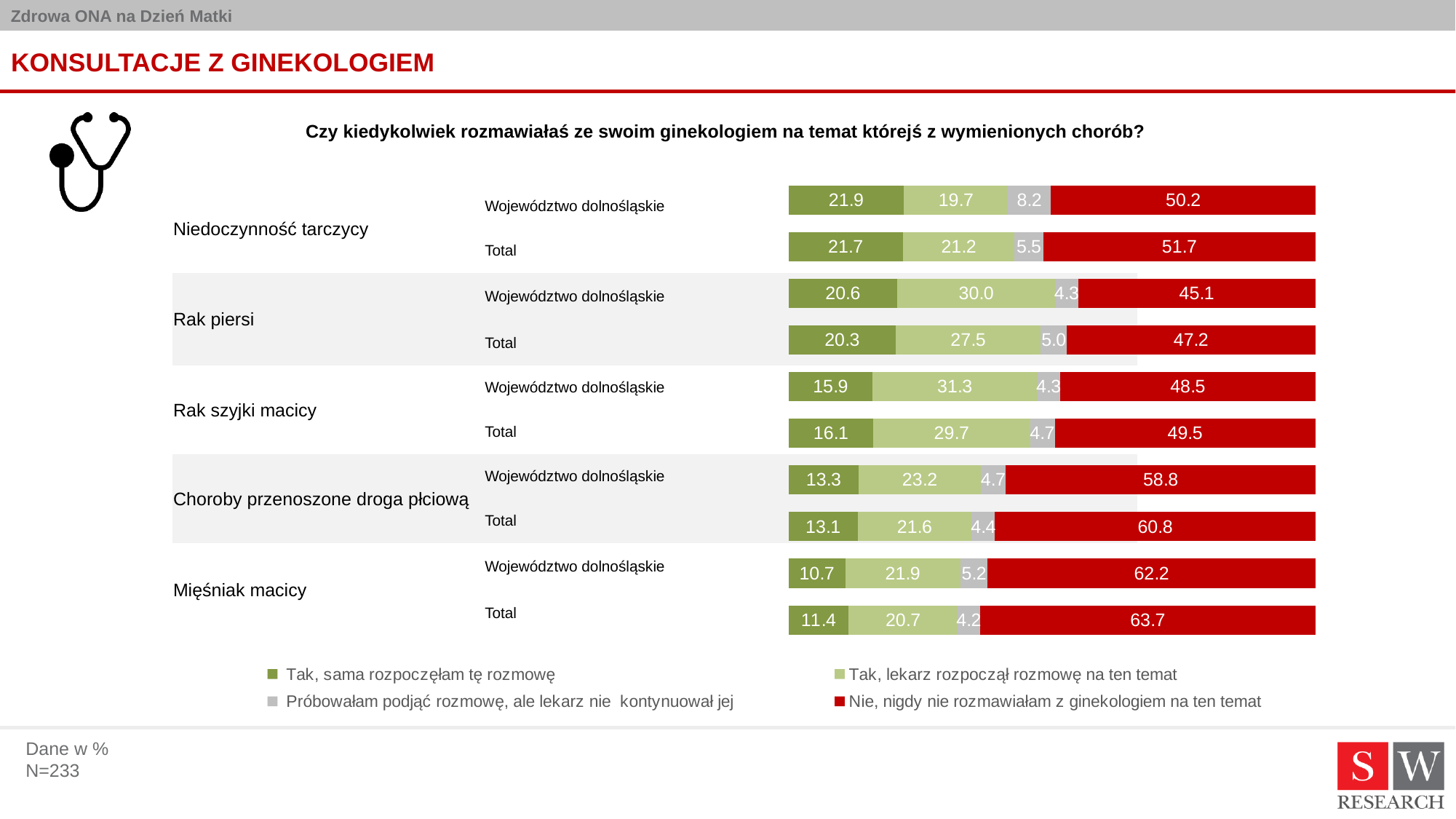
How many bars are shown in the chart? 10 For Choroby przenoszone droga płciową, what is the difference between the Total and Województwo dolnośląskie values for "Nie, nigdy nie rozmawiałam z ginekologiem na ten temat"? 2.0 What is the value for "Nie, nigdy nie rozmawiałam z ginekologiem na ten temat" in the Total bar for Mięśniak macicy? 63.7 For Województwo dolnośląskie, which has the larger value for "Tak, lekarz rozpoczął rozmowę na ten temat": Rak szyjki macicy or Rak piersi? Rak szyjki macicy Which bar has the highest value for "Tak, lekarz rozpoczął rozmowę na ten temat"? Rak szyjki macicy, Województwo dolnośląskie (31.3) How many series does the legend list? 4 What is the total of the Województwo dolnośląskie bar for Niedoczynność tarczycy? 100.0 What is the value for "Próbowałam podjąć rozmowę, ale lekarz nie kontynuował jej" in the Województwo dolnośląskie bar for Niedoczynność tarczycy? 8.2 What kind of chart is shown on the slide? Stacked bar chart What is the value for "Tak, sama rozpoczęłam tę rozmowę" in the Województwo dolnośląskie bar for Rak piersi? 20.6 Which bar has the highest value for "Nie, nigdy nie rozmawiałam z ginekologiem na ten temat"? Mięśniak macicy, Total (63.7) Which bar has the lowest value for "Tak, sama rozpoczęłam tę rozmowę"? Mięśniak macicy, Województwo dolnośląskie (10.7)